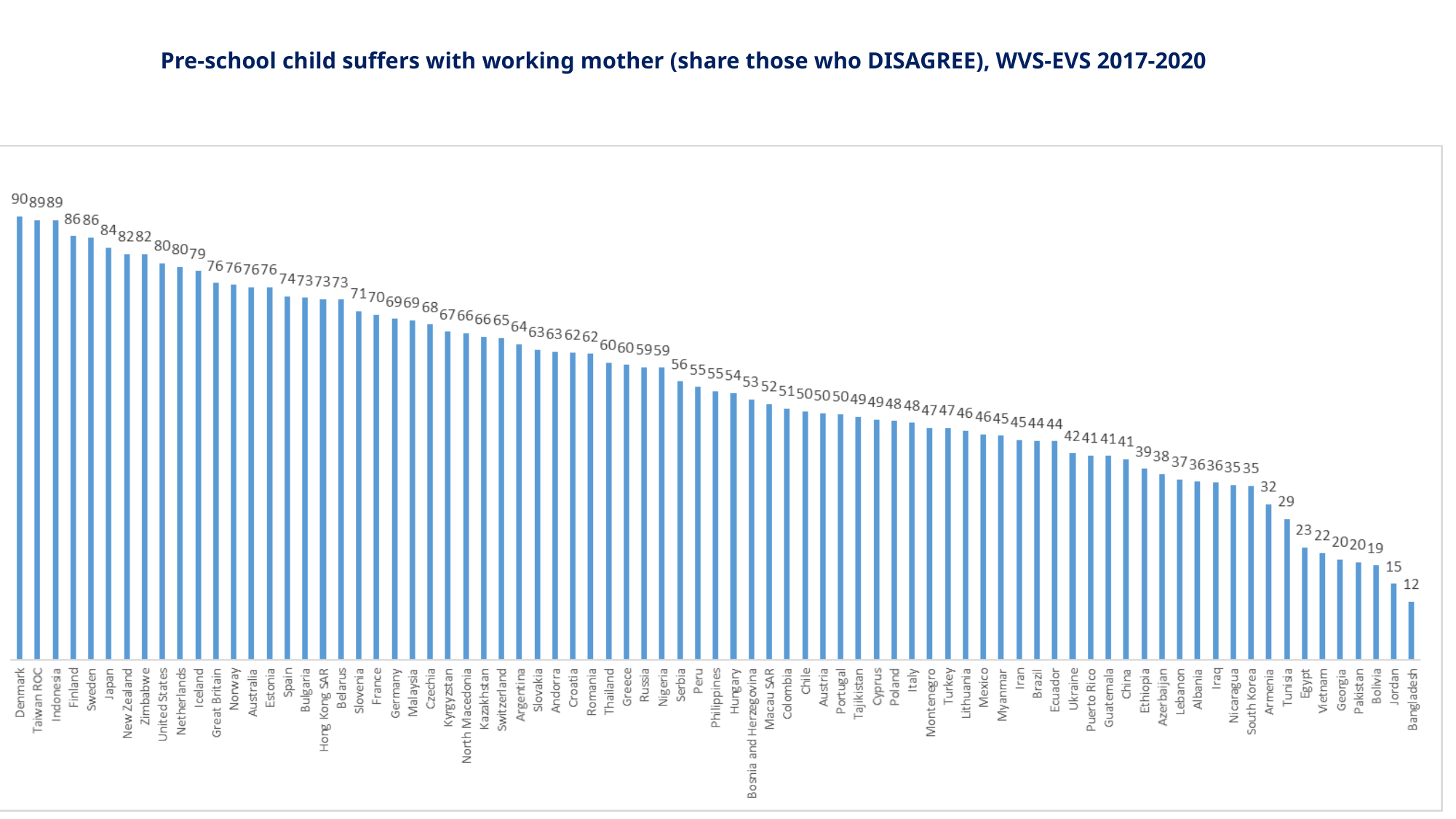
Do the values rise or fall moving from left to right along the x axis? fall Which country has the lowest value in the chart? Bangladesh What kind of chart is shown on the slide? bar chart What survey and years are named in the chart title? WVS-EVS 2017-2020 What is the value shown for Serbia? 56 What is the difference between the values for Finland and Armenia? 54 What is the value shown for Japan? 84 Which has a higher value, Spain or Greece? Spain What is the value shown for Denmark? 90 Which country has the highest value in the chart? Denmark What is the value shown for Jordan? 15 What is the difference between the values for Denmark and Bangladesh? 78